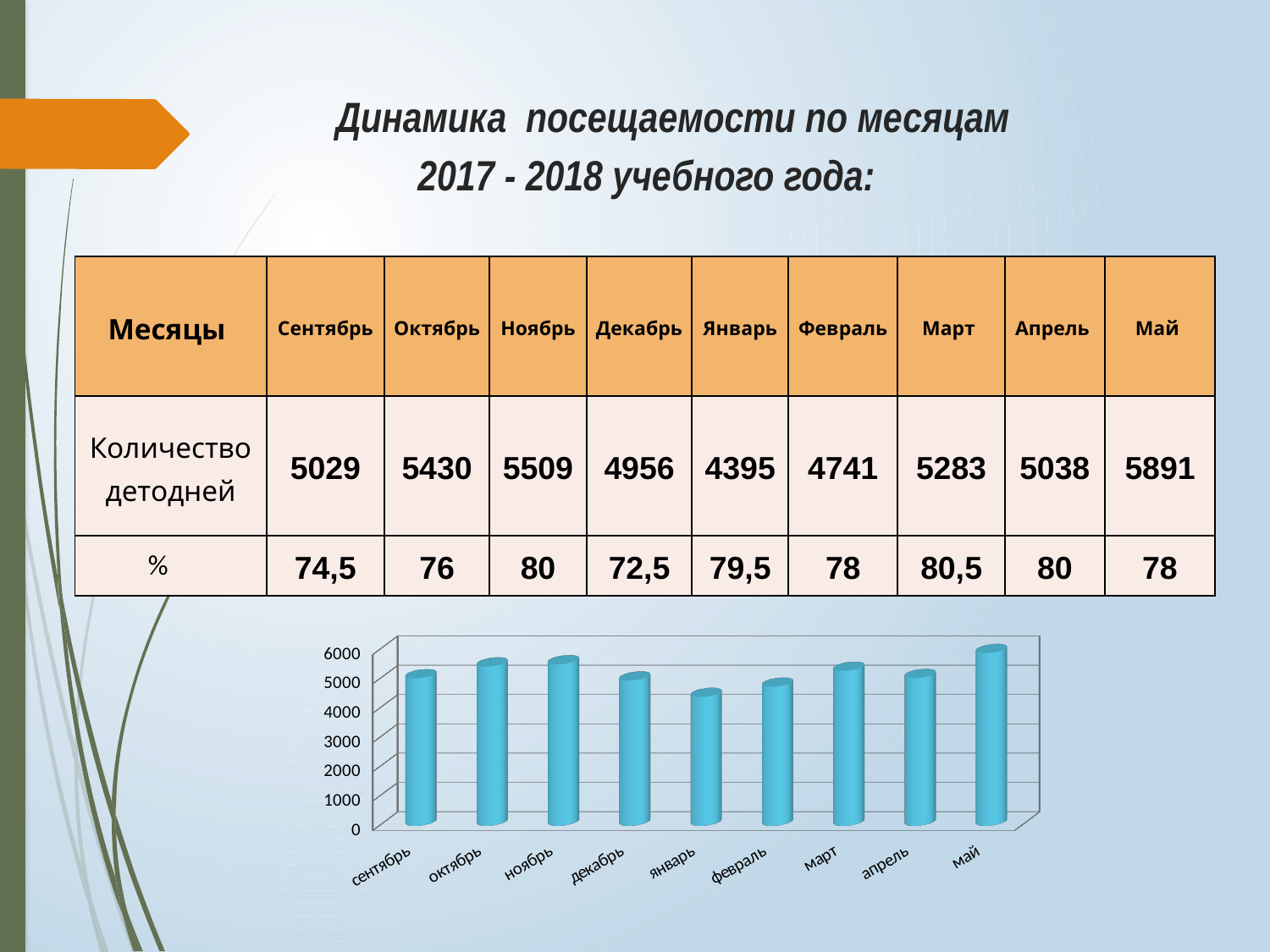
What is the value plotted for ноябрь? 5509 Is the value for январь greater or less than 5000? less Which is larger, the value for март or the value for апрель? март Is the value for октябрь greater or less than 5000? greater What is the value plotted for январь? 4395 What is the highest tick value shown on the vertical axis of the chart? 6000 Which month has the lowest bar on the chart? январь What kind of chart is shown on the slide? bar chart What is the value plotted for май? 5891 Which month has the highest bar on the chart? май What is the difference between the values for май and январь? 1496 How many months (categories) are plotted on the chart? 9